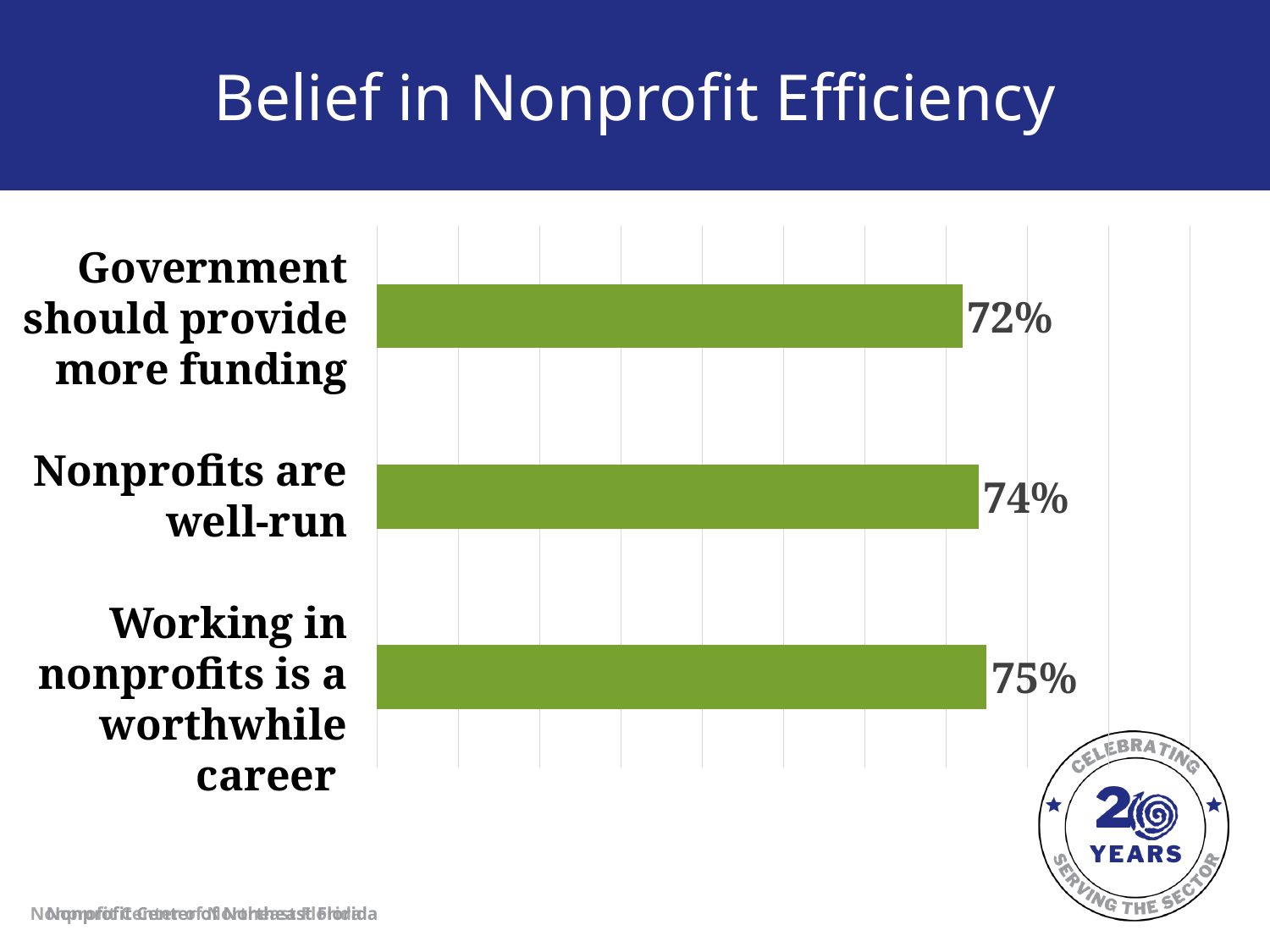
What percentage of respondents believe government should provide more funding? 72% What is the title of the slide? Belief in Nonprofit Efficiency What is the value for "Nonprofits are well-run"? 74% What is the value for "Working in nonprofits is a worthwhile career"? 75% What kind of chart is shown on the slide? Bar chart Which category has the highest value? Working in nonprofits is a worthwhile career Which is larger: the value for "Nonprofits are well-run" or "Government should provide more funding"? Nonprofits are well-run What is the difference between the values for "Nonprofits are well-run" and "Government should provide more funding"? 2% Which category has the lowest value? Government should provide more funding What colour are the bars in the chart? Green What is the difference between the values for "Working in nonprofits is a worthwhile career" and "Government should provide more funding"? 3% How many categories are shown in the chart? 3